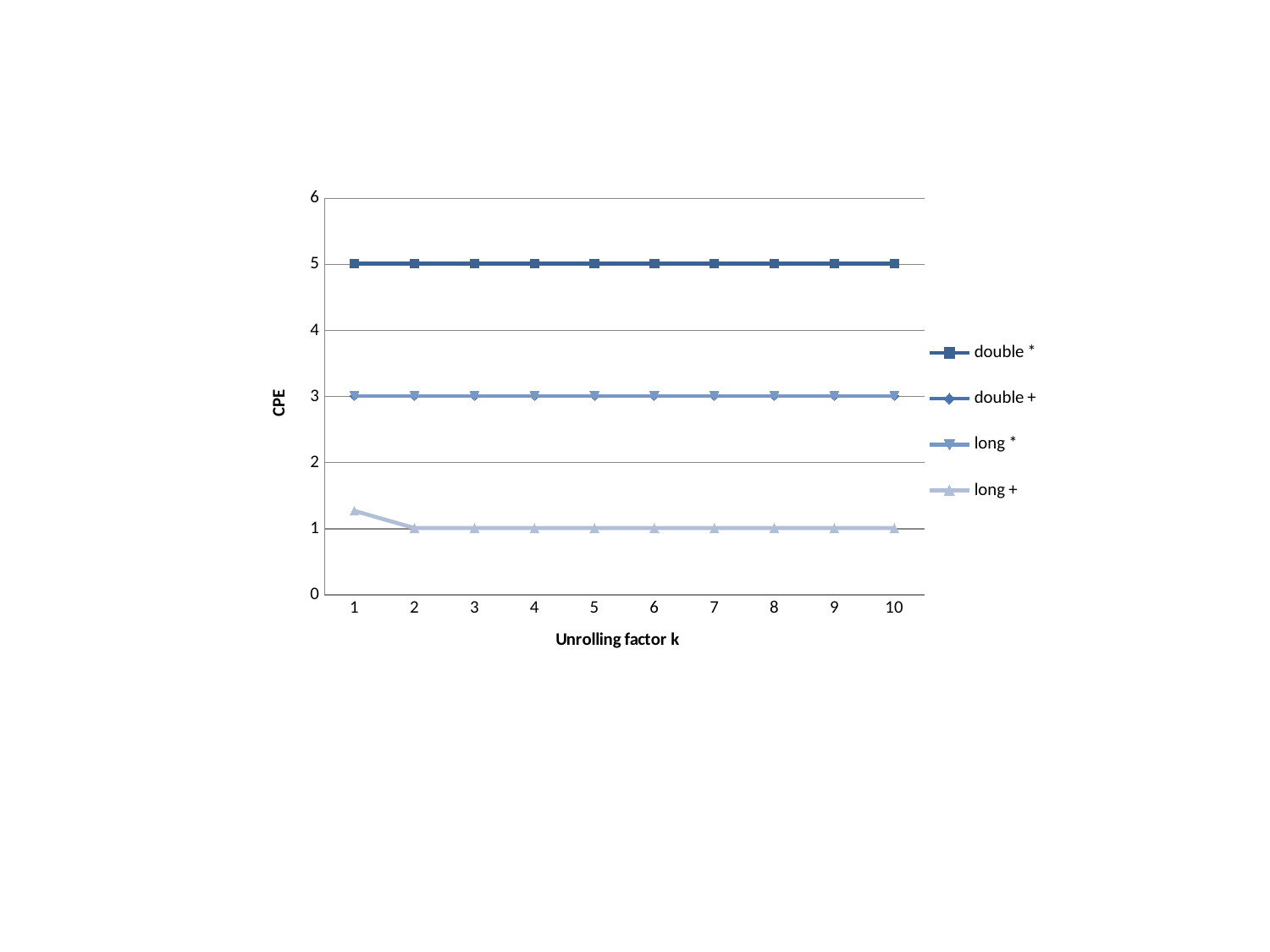
What is the difference in CPE between double * and long * at unrolling factor k = 2? 2 What is the CPE for long + at unrolling factor k = 10? 1 Does the CPE for double * rise, fall, or stay flat as the unrolling factor k increases from 1 to 10? stays flat Which series has the highest CPE across all unrolling factors? double * Is the CPE for long + at unrolling factor k = 1 greater or less than 2? less How many series does the legend list? 4 What is the CPE for double * at unrolling factor k = 5? 5 What is the CPE for long * at unrolling factor k = 3? 3 At unrolling factor k = 4, which has the larger CPE, double * or long *? double * What kind of chart is shown on the slide? line chart How many unrolling factor values are plotted along the x axis? 10 What is the label of the x axis? Unrolling factor k